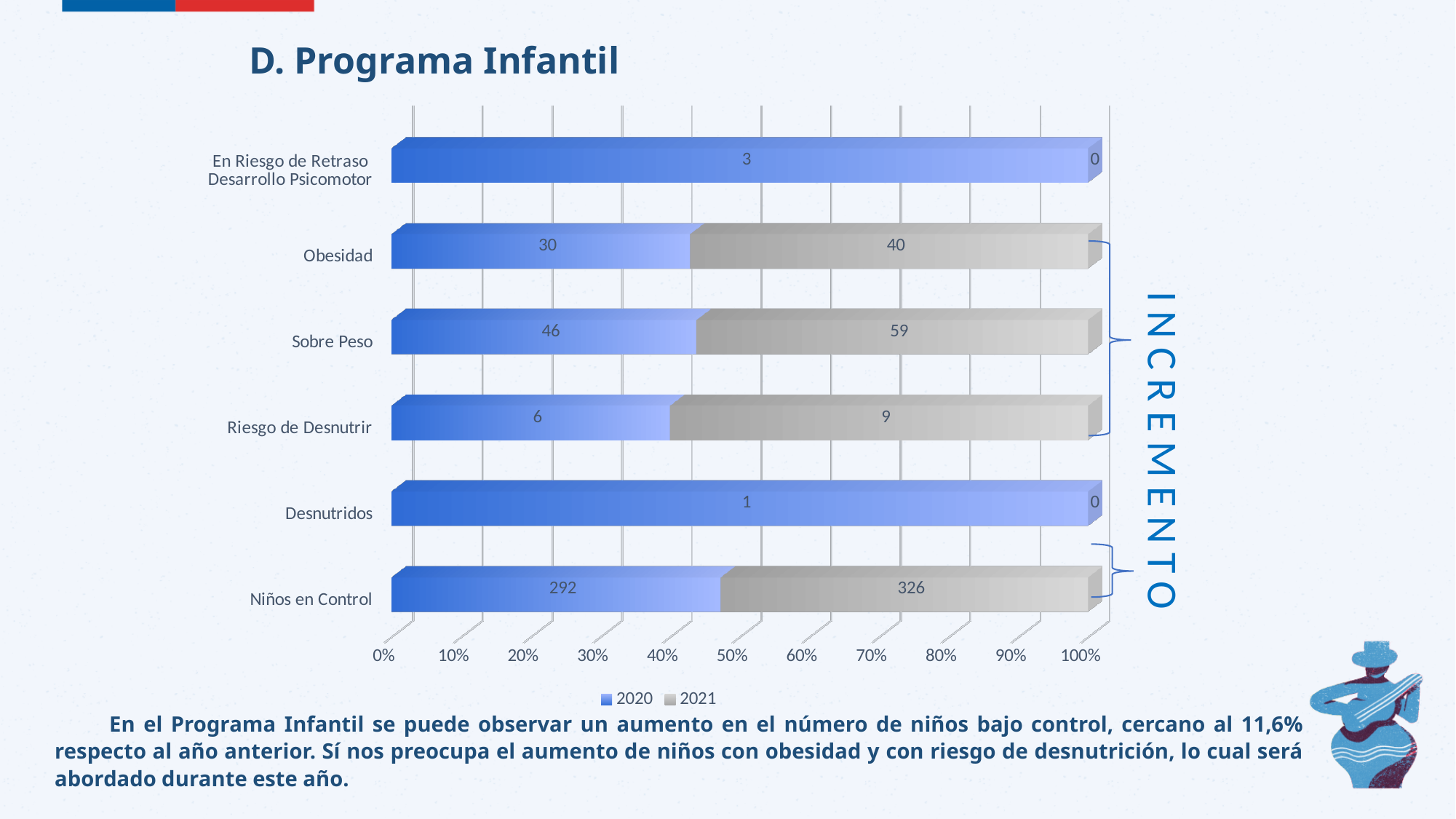
What kind of chart is shown on the slide? Bar chart What are the two series named in the legend? 2020 and 2021 What is the 2021 value for Sobre Peso? 59 What is the 2021 value for Obesidad? 40 By how much did Niños en Control increase from 2020 to 2021? 34 How many series does the legend list? 2 For Obesidad, which year has the larger value, 2020 or 2021? 2021 How many categories are shown on the chart? 6 What is the difference between the 2021 and 2020 values for Sobre Peso? 13 What is the 2020 value for Desnutridos? 1 Which category has the highest 2021 value? Niños en Control What is the 2020 value for Niños en Control? 292